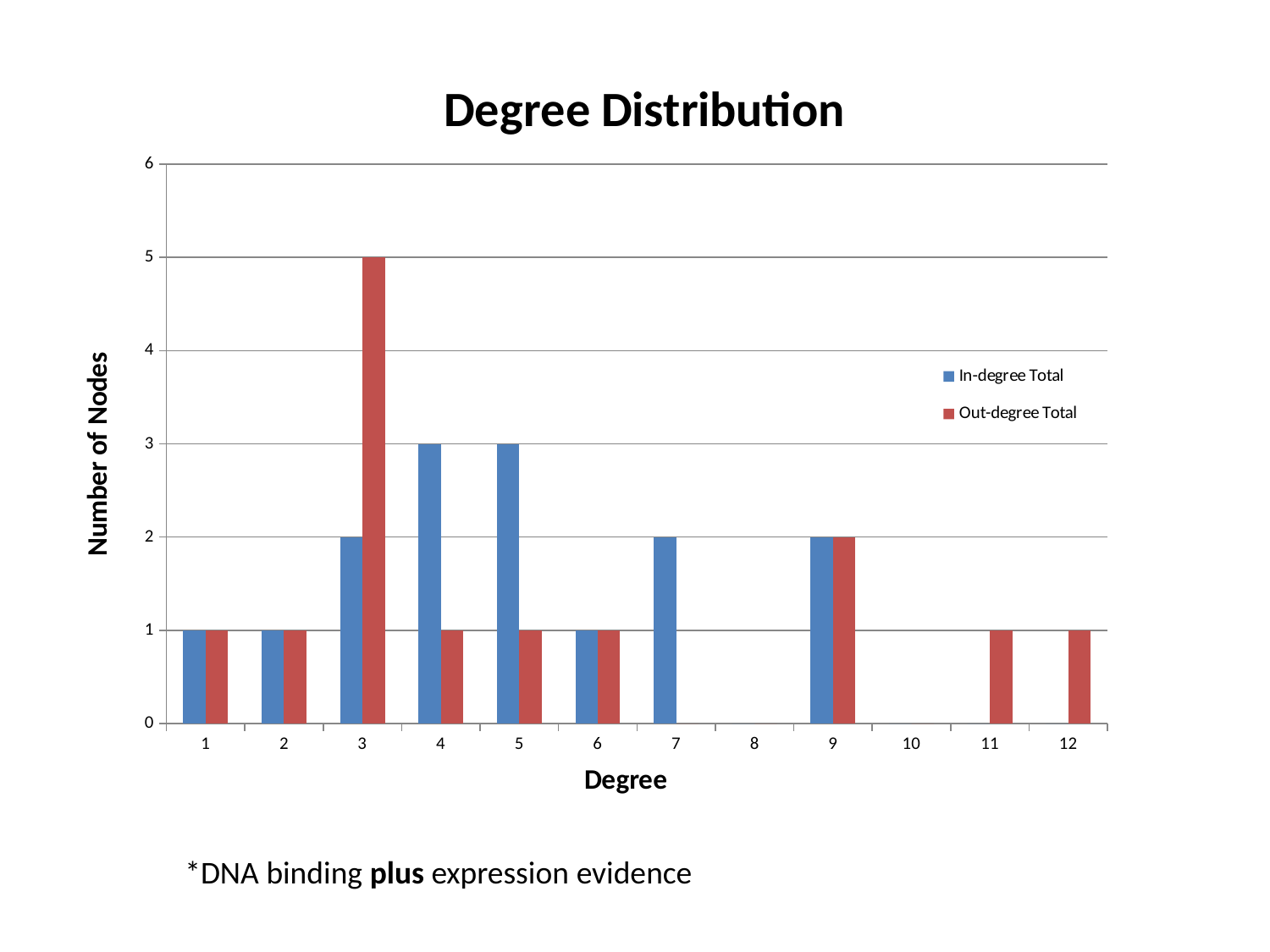
At which degree is the Out-degree Total highest? 3 How many degree categories are shown on the x axis? 12 What is the label of the y axis? Number of Nodes What is the In-degree Total for degree 7? 2 How many series does the legend list? 2 What is the difference between the Out-degree Total and the In-degree Total at degree 3? 3 What is the Out-degree Total for degree 3? 5 What kind of chart is shown on the slide? bar chart Is the Out-degree Total for degree 3 greater or less than 4? greater What is the title of the chart? Degree Distribution What is the In-degree Total for degree 4? 3 At degree 5, which is larger: the In-degree Total or the Out-degree Total? In-degree Total